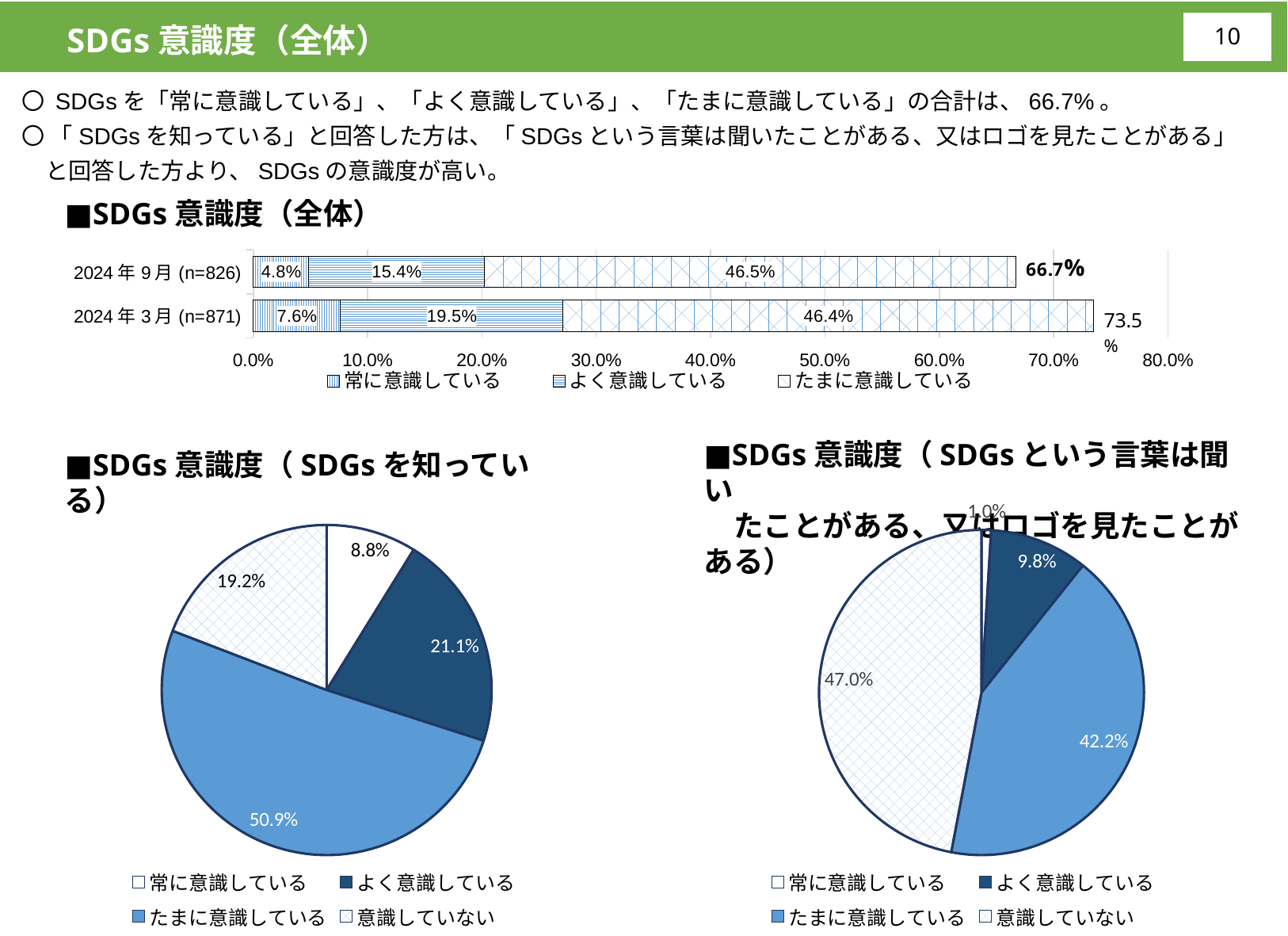
In the pie chart 'SDGs 意識度（SDGsを知っている）', which category has the smallest share? 常に意識している What kind of chart is 'SDGs 意識度（全体）'? Stacked bar chart In the bar chart 'SDGs 意識度（全体）', how many series does the legend list? 3 In the bar chart 'SDGs 意識度（全体）', what is the value of 'よく意識している' for 2024年9月 (n=826)? 15.4% In the bar chart 'SDGs 意識度（全体）', what is the total of the stacked bar for 2024年3月 (n=871)? 73.5% In the bar chart 'SDGs 意識度（全体）', what is the value of '常に意識している' for 2024年3月 (n=871)? 7.6% In the bar chart 'SDGs 意識度（全体）', what is the difference between the 'よく意識している' values for 2024年3月 and 2024年9月? 4.1% In the bar chart 'SDGs 意識度（全体）', what is the total of the stacked bar for 2024年9月 (n=826)? 66.7% In the pie chart 'SDGs 意識度（SDGsという言葉は聞いたことがある、又はロゴを見たことがある）', which category has the largest share? 意識していない Which is larger: 'たまに意識している' in the pie chart 'SDGs 意識度（SDGsを知っている）' or 'たまに意識している' in the pie chart 'SDGs 意識度（SDGsという言葉は聞いたことがある、又はロゴを見たことがある）'? SDGs 意識度（SDGsを知っている） In the pie chart 'SDGs 意識度（SDGsを知っている）', what share does 'たまに意識している' have? 50.9% In the pie chart 'SDGs 意識度（SDGsという言葉は聞いたことがある、又はロゴを見たことがある）', what share does 'よく意識している' have? 9.8%